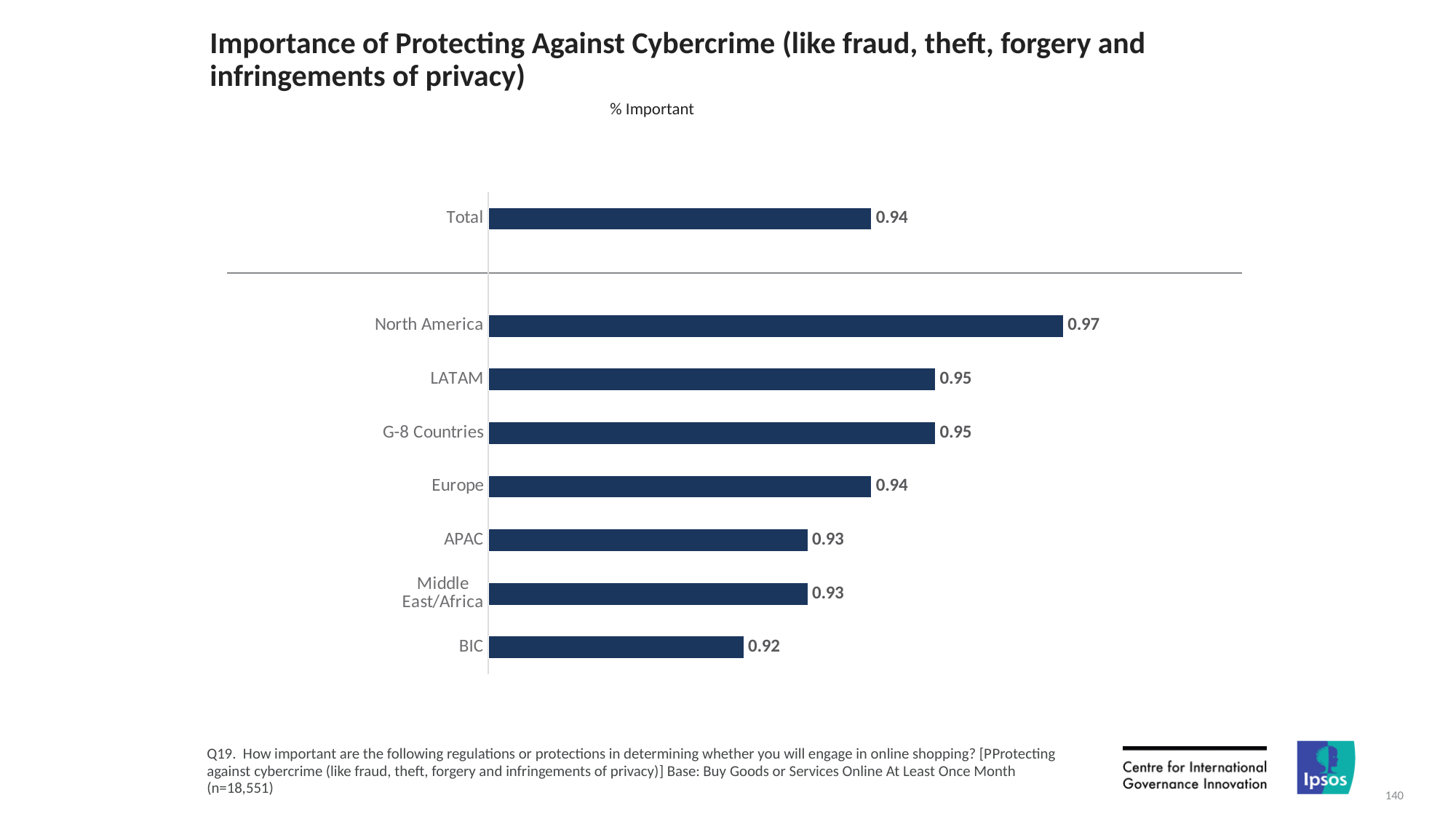
Which region has the highest value? North America What kind of chart is shown on the slide? Bar chart What is the value for Middle East/Africa? 0.93 How many bars are shown in the chart? 8 What is the value for Total? 0.94 What is the value for North America? 0.97 What is the difference between the values for North America and BIC? 0.05 Which is larger, the value for Europe or the value for North America? North America What is the value for BIC? 0.92 What is the difference between the values for LATAM and APAC? 0.02 What is the label shown above the chart? % Important Which region has the lowest value? BIC